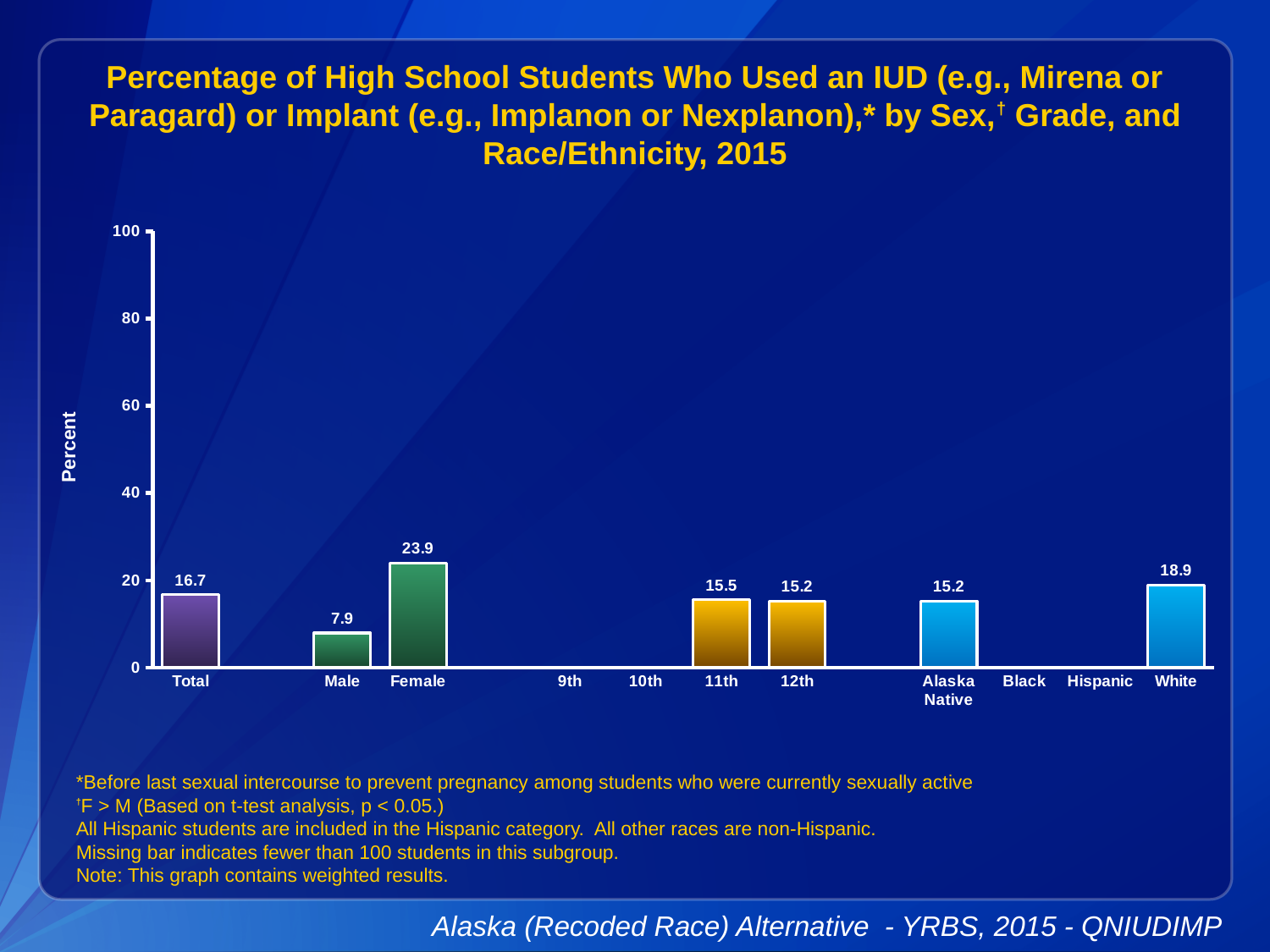
What is the value for White? 18.9 What kind of chart is shown? bar chart Which category with a plotted bar has the lowest value? Male Which is larger, the value for 11th grade or the value for 12th grade? 11th What is the value for Total? 16.7 How many categories have a plotted bar? 7 What is the value for Female? 23.9 What is the value for Male? 7.9 Is the value for Female greater or less than 20? greater Which category has the highest value? Female What is the difference between the Female and Male values? 16.0 What is the label of the y axis? Percent